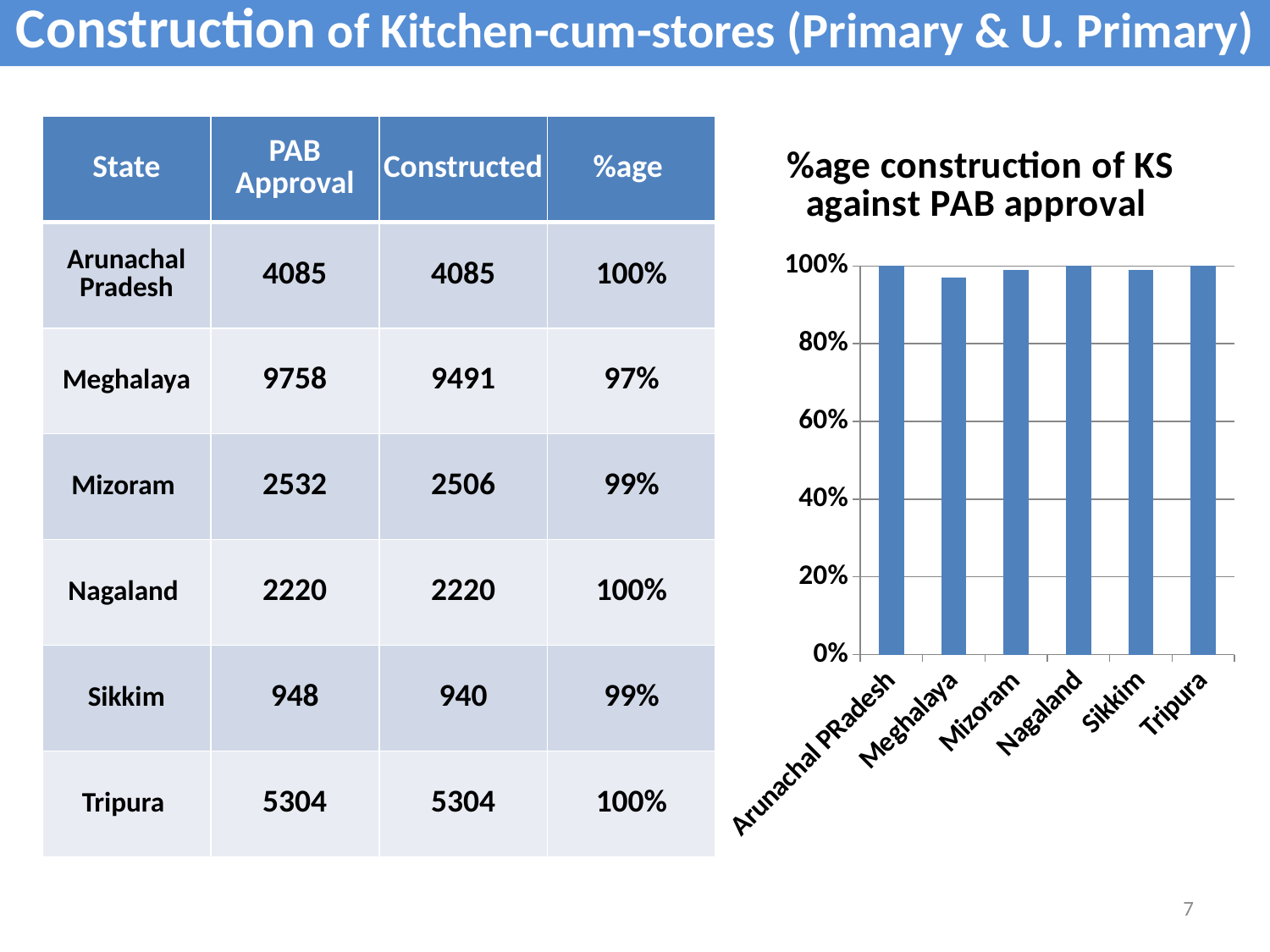
What is the difference between the %age values for Tripura and Meghalaya? 3% Which state has the lowest %age construction in the chart? Meghalaya Is the value for Meghalaya greater or less than 80%? greater What is the %age construction value for Meghalaya? 97% What is the %age construction value for Tripura? 100% Which is larger, the value for Arunachal Pradesh or the value for Meghalaya? Arunachal Pradesh How many states are plotted in the chart? 6 What is the %age construction value for Sikkim? 99% What is the title of the chart? %age construction of KS against PAB approval What is the %age construction value for Nagaland? 100% What kind of chart is shown on the slide? bar chart Is the value for Mizoram greater or less than 60%? greater